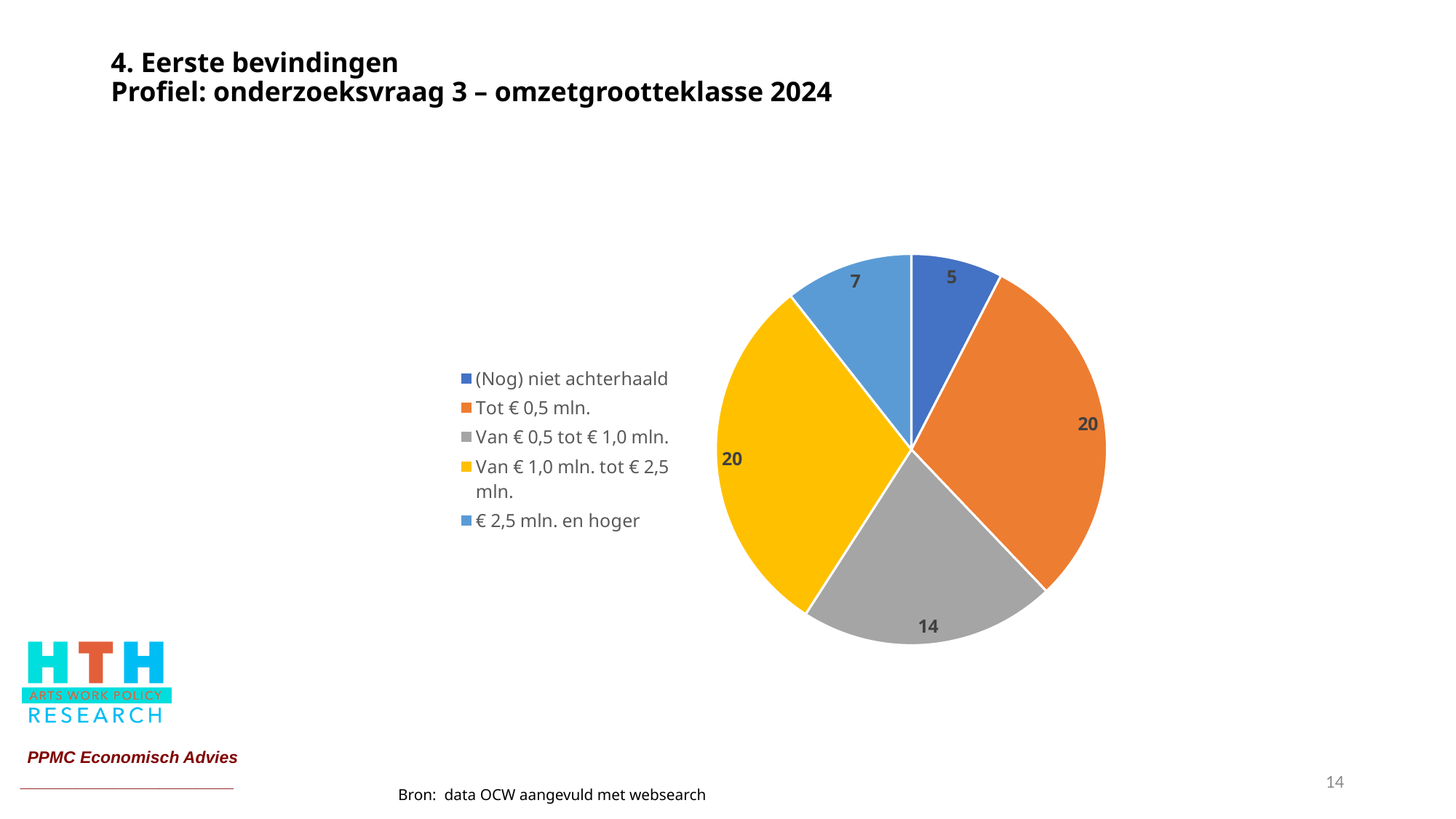
Which category has the smallest slice in the pie chart? (Nog) niet achterhaald Which colour represents 'Van € 1,0 mln. tot € 2,5 mln.' in the pie chart? Yellow How many slices does the pie chart have? 5 What is the difference between the values for 'Tot € 0,5 mln.' and 'Van € 0,5 tot € 1,0 mln.'? 6 What value is shown for the '(Nog) niet achterhaald' slice? 5 What is the total of all the slice values in the pie chart? 66 Which is larger: the value for 'Van € 1,0 mln. tot € 2,5 mln.' or the value for '€ 2,5 mln. en hoger'? Van € 1,0 mln. tot € 2,5 mln. What value is shown for the '€ 2,5 mln. en hoger' slice? 7 What value is shown for the 'Tot € 0,5 mln.' slice? 20 What kind of chart is shown on the slide? Pie chart What is the difference between the values for '€ 2,5 mln. en hoger' and '(Nog) niet achterhaald'? 2 What value is shown for the 'Van € 0,5 tot € 1,0 mln.' slice? 14